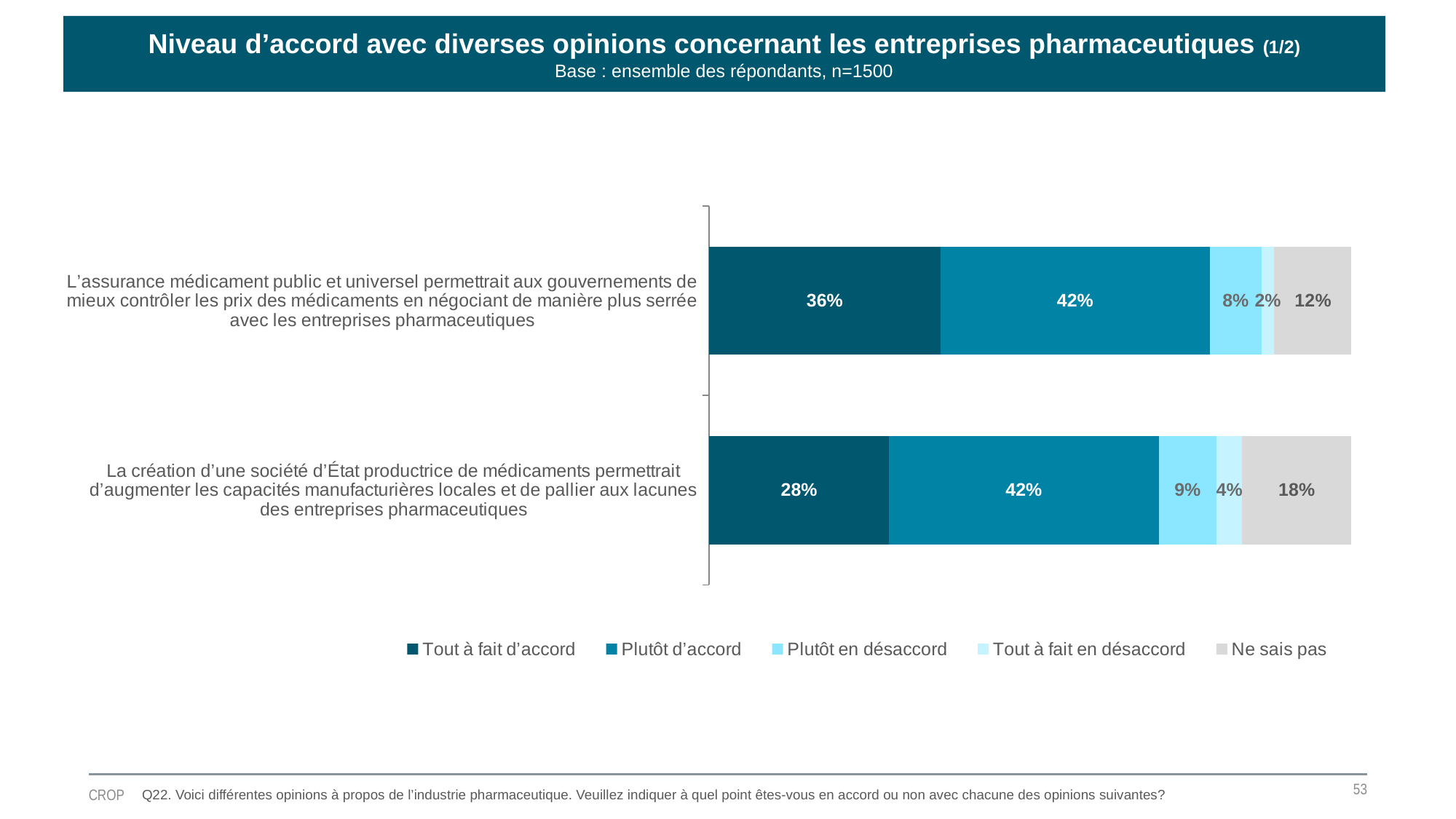
Which statement has the higher "Tout à fait d'accord" share: the one about public and universal drug insurance or the one about a state-owned drug manufacturing company? L'assurance médicament public et universel How many series does the legend list? 5 What is the difference in the "Tout à fait d'accord" share between the public drug insurance statement and the state-owned company statement? 8 percentage points What percentage of respondents answered "Ne sais pas" for the statement about creating a state-owned drug manufacturing company (La création d'une société d'État)? 18% What kind of chart is shown on the slide? Stacked horizontal bar chart What is the combined share of "Tout à fait d'accord" and "Plutôt d'accord" for the statement about a state-owned drug manufacturing company? 70% What is the difference in the "Ne sais pas" share between the state-owned company statement and the public drug insurance statement? 6 percentage points What is the combined share of "Tout à fait d'accord" and "Plutôt d'accord" for the statement about public and universal drug insurance? 78% How many statements (categories) are shown in the chart? 2 What percentage of respondents answered "Tout à fait d'accord" for the statement about public and universal drug insurance (L'assurance médicament public et universel)? 36% What percentage answered "Tout à fait en désaccord" for the statement about creating a state-owned drug manufacturing company? 4% What percentage answered "Plutôt en désaccord" for the statement about public and universal drug insurance? 8%